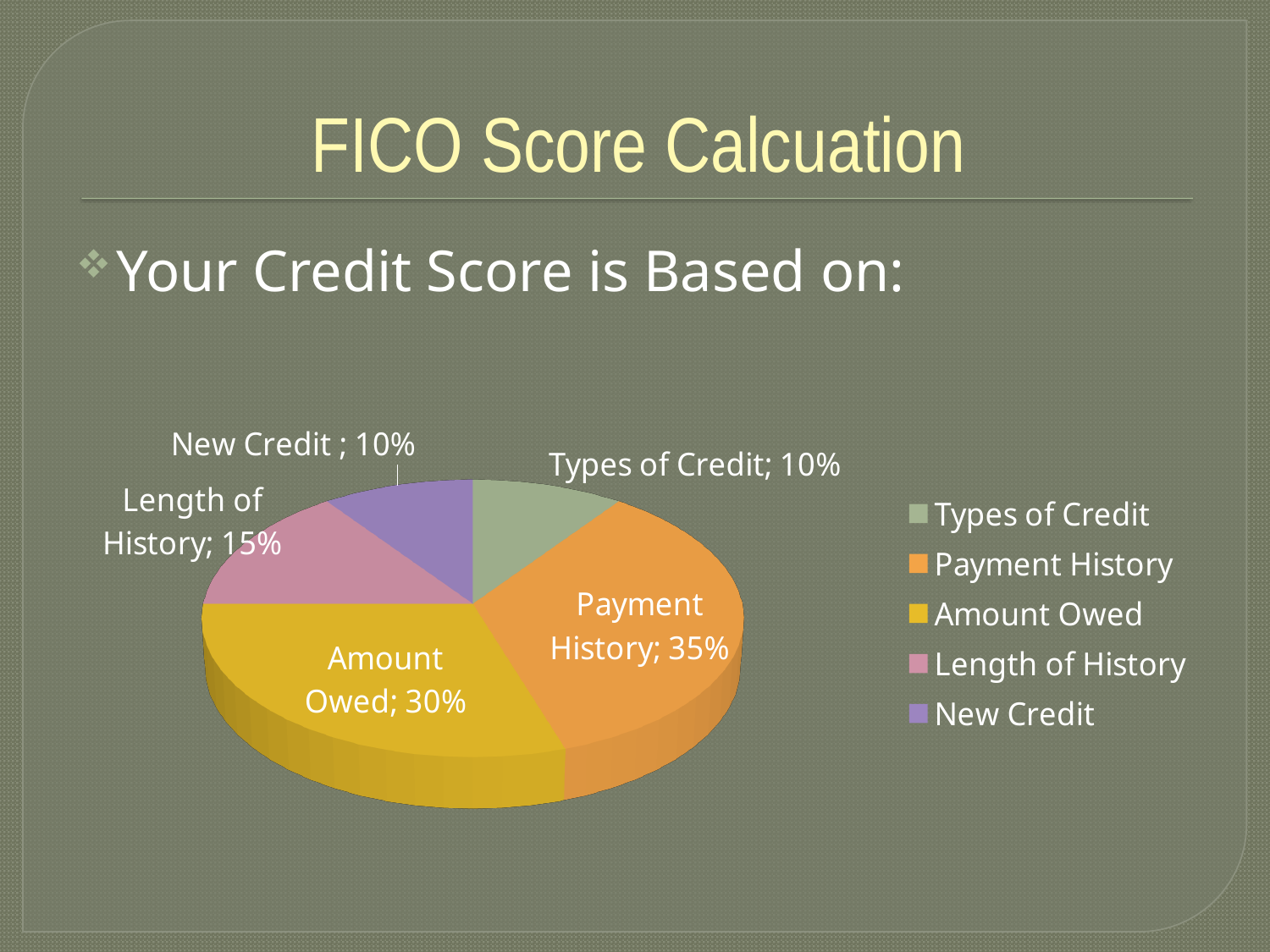
What kind of chart is shown on the slide? Pie chart What is the difference between the Payment History share and the Amount Owed share? 5% What share of the pie does Payment History represent? 35% Which category has the largest slice of the pie? Payment History Which category is shown in purple in the legend? New Credit Which is larger, the share for Length of History or the share for Types of Credit? Length of History How many categories are shown in the pie chart? 5 What is the combined share of Types of Credit and New Credit? 20% What is the difference between the Amount Owed share and the Length of History share? 15% What share of the pie does Amount Owed represent? 30% What share of the pie does New Credit represent? 10% What share of the pie does Length of History represent? 15%